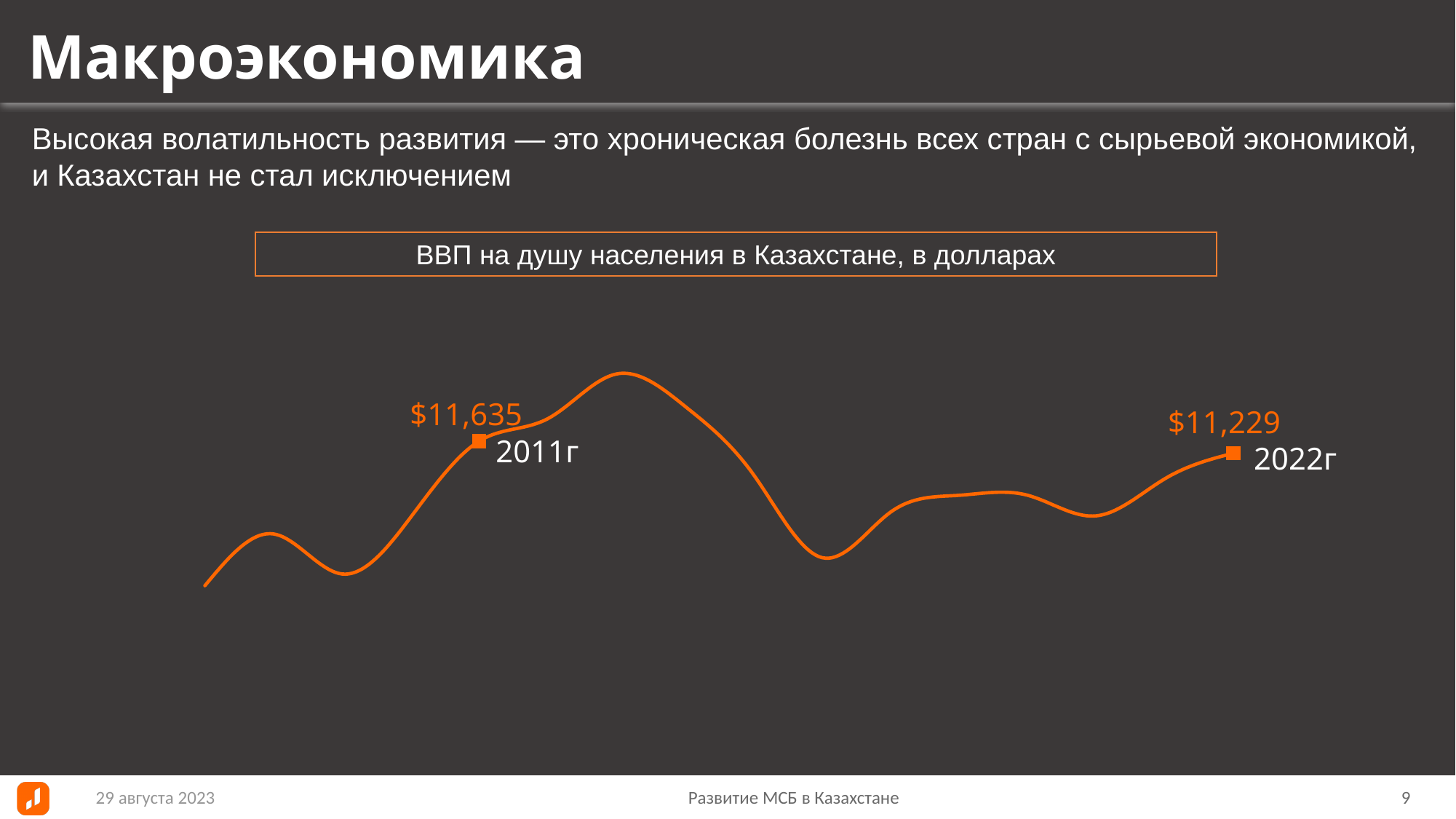
What colour is the line in the chart? Orange What is the GDP per capita value shown for 2022 on the chart? $11,229 How many data points on the line are labeled with a value? 2 What is the title of the chart? ВВП на душу населения в Казахстане, в долларах What is the difference between the labeled values for 2011 and 2022? $406 What kind of chart is shown on the slide? Line chart What is the GDP per capita value shown for 2011 on the chart? $11,635 Of the two labeled points, which year has the lower value? 2022 Comparing the labeled value for 2011 with the labeled value for 2022, did GDP per capita rise or fall? Fall Which of the two labeled years, 2011 or 2022, has the higher GDP per capita value? 2011